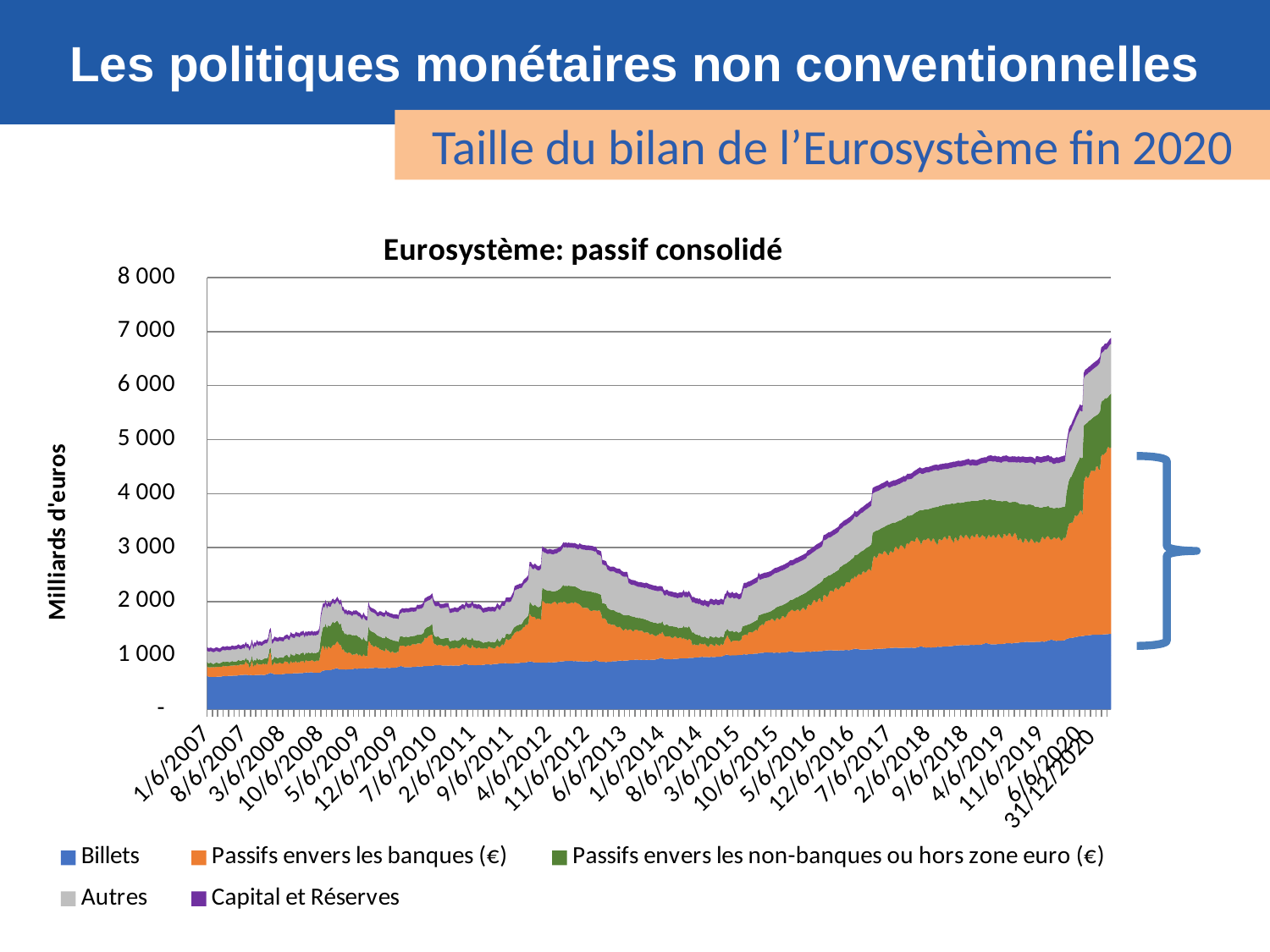
Is the value of Billets at the end of 2020 greater or less than 1 000? greater What is the highest value shown on the vertical axis? 8 000 Is the value of Billets at 1/6/2007 greater or less than 1 000? less What is the label of the vertical axis? Milliards d'euros Does the total consolidated liability generally rise or fall from 2007 to 2020? Rise Is the total consolidated liability at 1/6/2007 greater or less than 2 000? less How many series does the legend list? 5 What is the title of the chart? Eurosystème: passif consolidé Which series is the largest component of the total at the end of 2020? Passifs envers les banques (€) Is the total consolidated liability larger at the 2012 peak or at the end of 2020? End of 2020 What kind of chart is shown on the slide? Stacked area chart